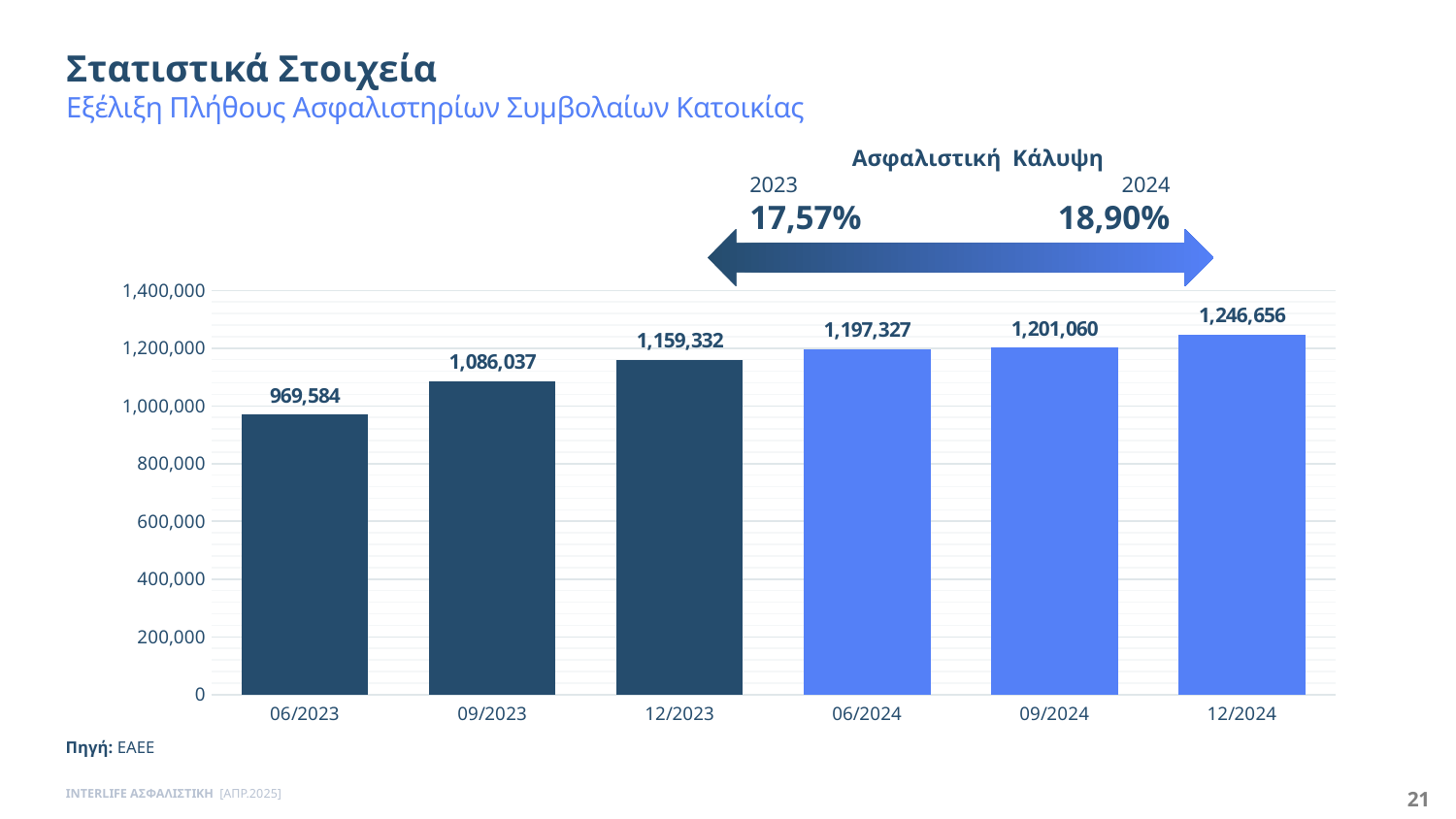
What is the value for 06/2023? 969,584 Which is larger, the value for 12/2023 or the value for 06/2024? 06/2024 How many periods are shown on the x axis? 6 Do the values rise or fall from 06/2023 to 12/2024? rise What is the value for 09/2023? 1,086,037 Which period has the highest value? 12/2024 What is the difference between the values for 09/2023 and 06/2023? 116,453 What is the difference between the values for 12/2024 and 06/2023? 277,072 Is the value for 06/2023 greater or less than 1,000,000? less Which period has the lowest value? 06/2023 What kind of chart is shown on the slide? bar chart What is the value for 12/2024? 1,246,656